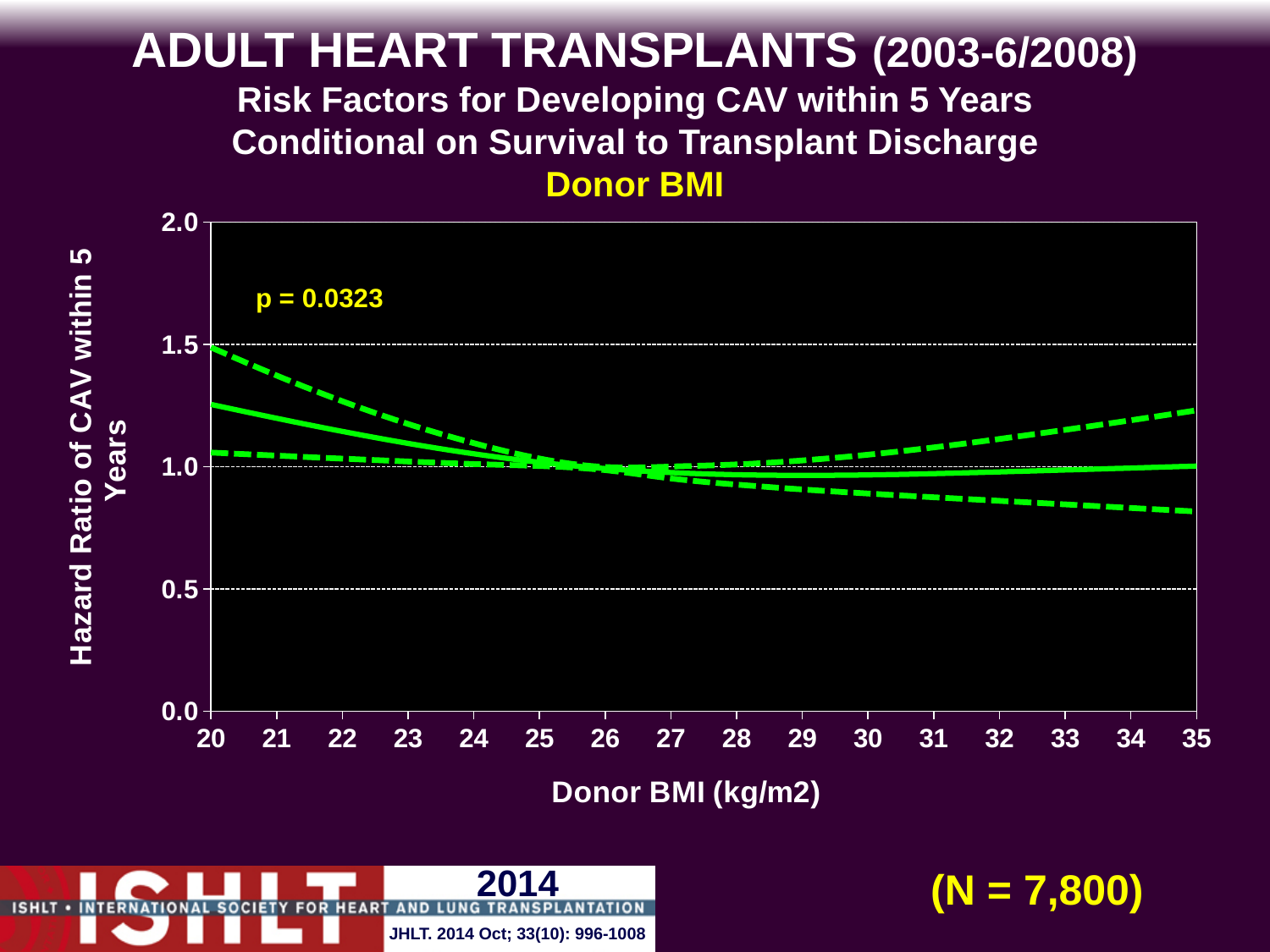
Is the lower dashed line at a Donor BMI of 35 greater or less than 1.0? less Is the solid hazard ratio line at a Donor BMI of 20 greater or less than 1.0? greater Does the solid hazard ratio line rise or fall as Donor BMI increases from 20 to 27? fall What kind of chart is shown on the slide? line chart Is the upper dashed line at a Donor BMI of 35 greater or less than 1.0? greater How many tick labels are shown on the Donor BMI x axis? 16 What p-value is printed on the chart? p = 0.0323 Which is larger: the solid hazard ratio line at a Donor BMI of 20 or at a Donor BMI of 35? Donor BMI of 20 How many lines are plotted on the chart? 3 What is the label of the x axis? Donor BMI (kg/m2)